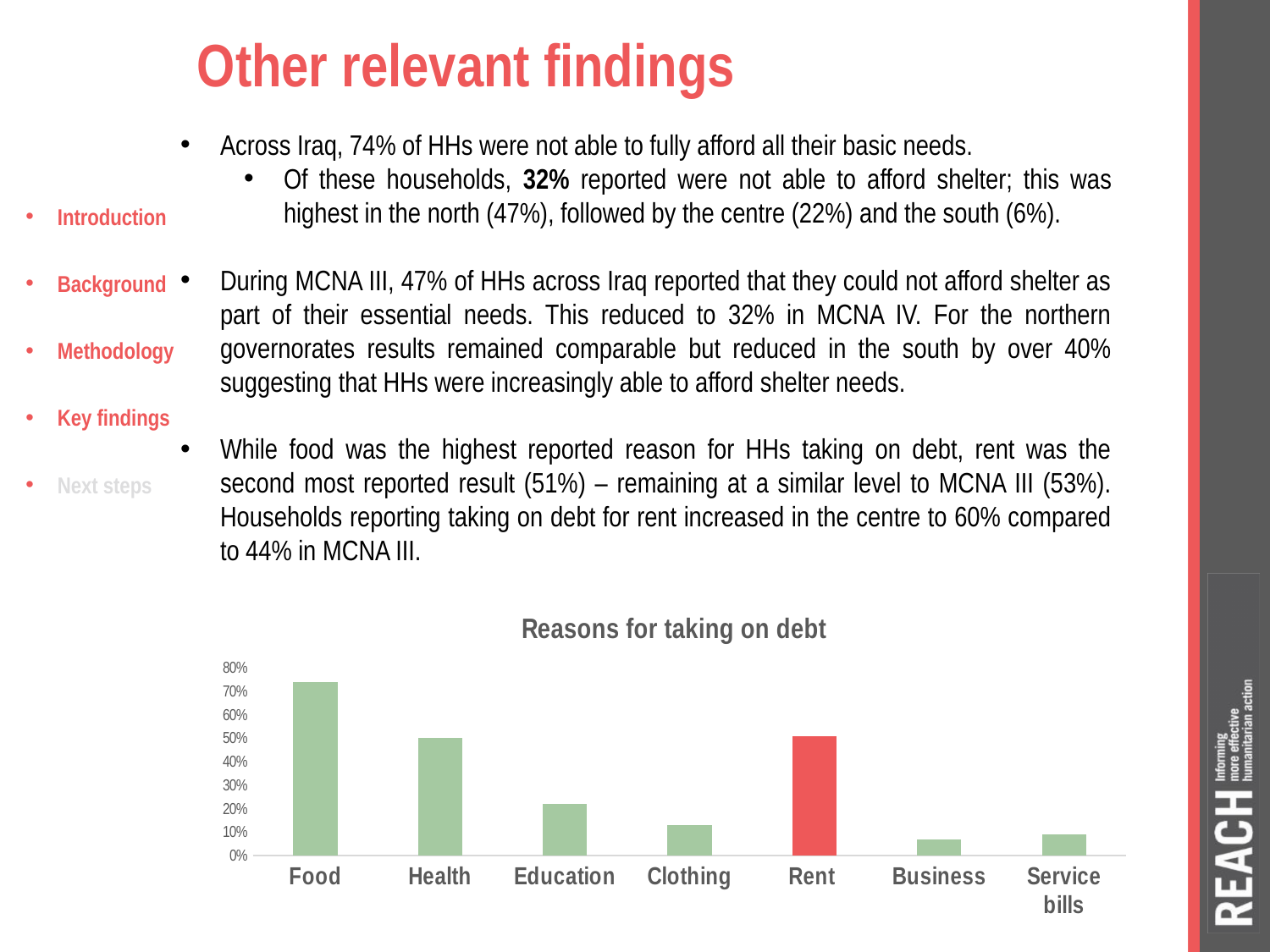
Is the value for Food greater or less than 70%? greater Which reason for taking on debt has the lowest bar? Business Which reason for taking on debt has the highest bar? Food Which is larger, the value for Food or the value for Rent? Food Which is larger, the value for Education or the value for Clothing? Education Is the value for Rent greater or less than 40%? greater How many categories are shown on the x axis of the chart? 7 Is the value for Business greater or less than 10%? less What is the title of the chart? Reasons for taking on debt Which bar in the chart is coloured red rather than green? Rent What kind of chart is shown on the slide? bar chart